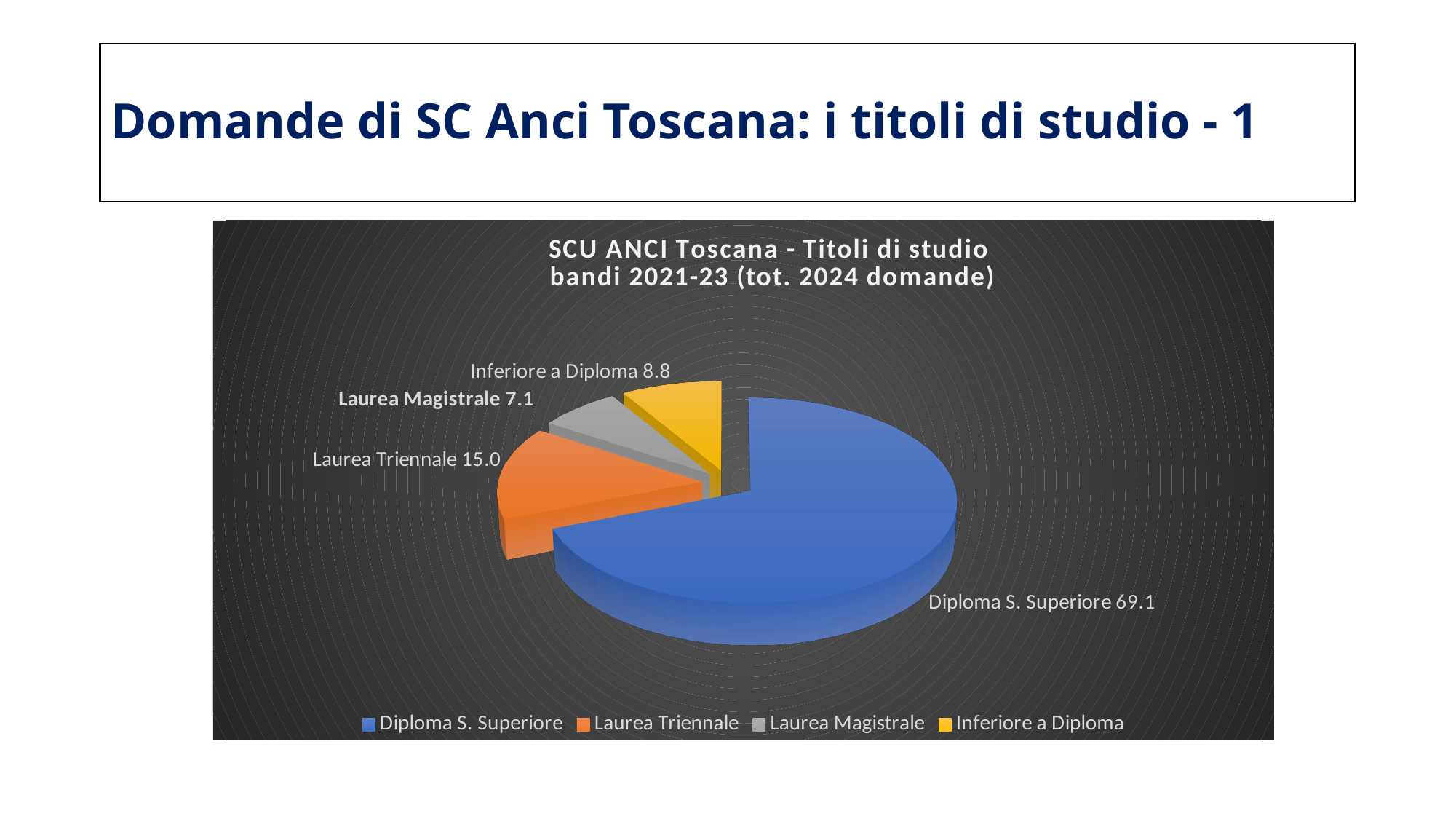
What value is shown for Inferiore a Diploma? 8.8 What colour is the Laurea Triennale slice? Orange Which category has the largest slice of the pie? Diploma S. Superiore What kind of chart is shown on the slide? Pie chart What value is shown for Laurea Magistrale? 7.1 How many categories does the pie chart show? 4 Which category has the smallest slice of the pie? Laurea Magistrale Which is larger, the value for Inferiore a Diploma or the value for Laurea Magistrale? Inferiore a Diploma What value is shown for Laurea Triennale? 15.0 What value is shown for Diploma S. Superiore? 69.1 What is the title of the chart? SCU ANCI Toscana - Titoli di studio bandi 2021-23 (tot. 2024 domande) What is the difference between the values for Diploma S. Superiore and Laurea Triennale? 54.1